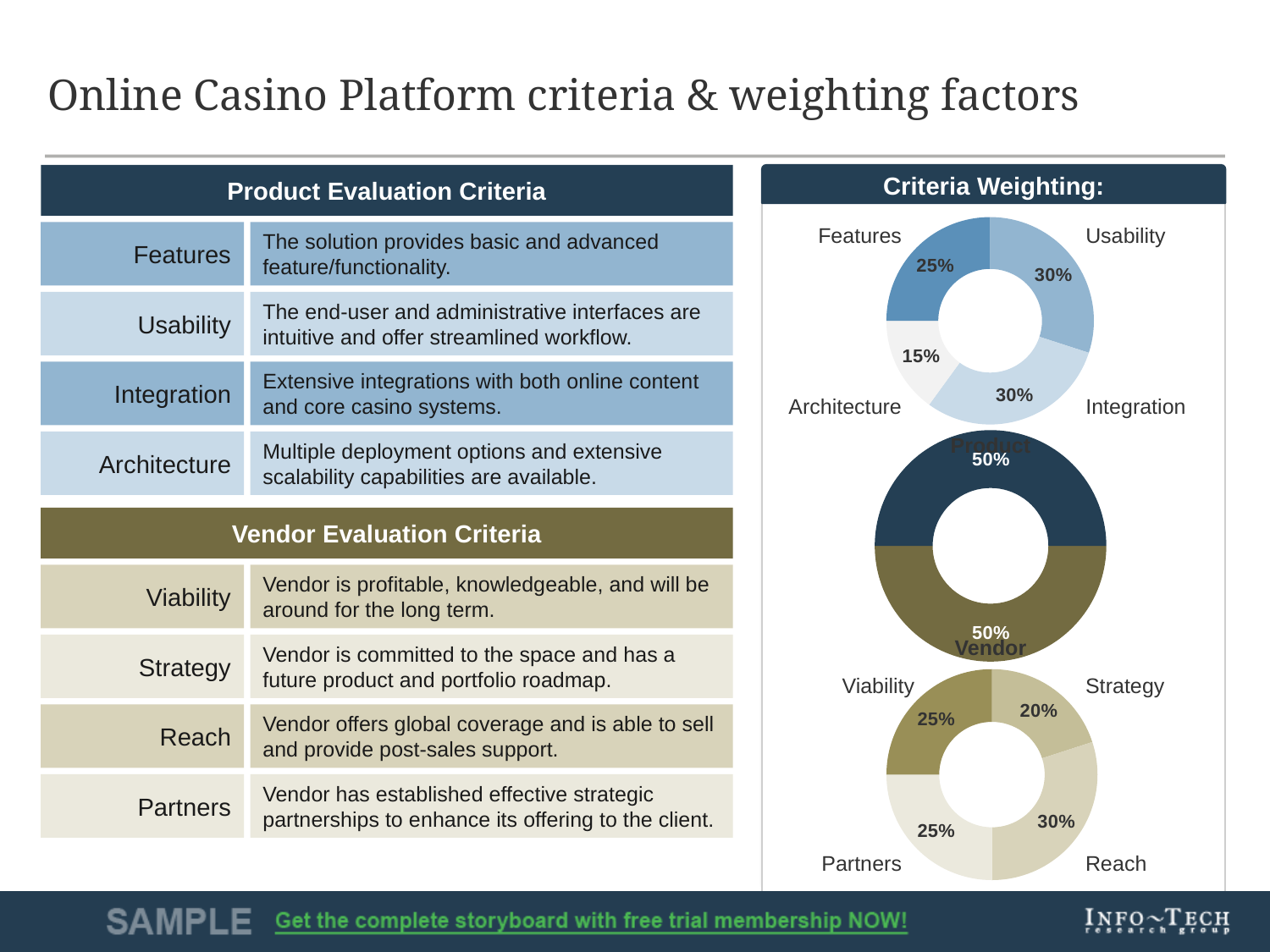
In the middle donut chart under Criteria Weighting, how many segments are there? 2 In the top donut chart under Criteria Weighting, what is the weighting for Architecture? 15% In the bottom donut chart under Criteria Weighting, which criterion has the highest weighting? Reach In the top donut chart under Criteria Weighting, which criterion has the lowest weighting? Architecture In the bottom donut chart under Criteria Weighting, what is the difference between the Reach and Strategy weightings? 10% In the bottom donut chart under Criteria Weighting, which is larger, the weighting for Viability or for Strategy? Viability What kind of chart is used to show the criteria weightings on the slide? Donut chart In the bottom donut chart under Criteria Weighting, what is the weighting for Strategy? 20% In the top donut chart under Criteria Weighting, what is the weighting for Features? 25% In the top donut chart under Criteria Weighting, what is the difference between the Usability and Architecture weightings? 15% In the middle donut chart under Criteria Weighting, what is the weighting for Vendor? 50% In the top donut chart under Criteria Weighting, how many criteria are shown? 4